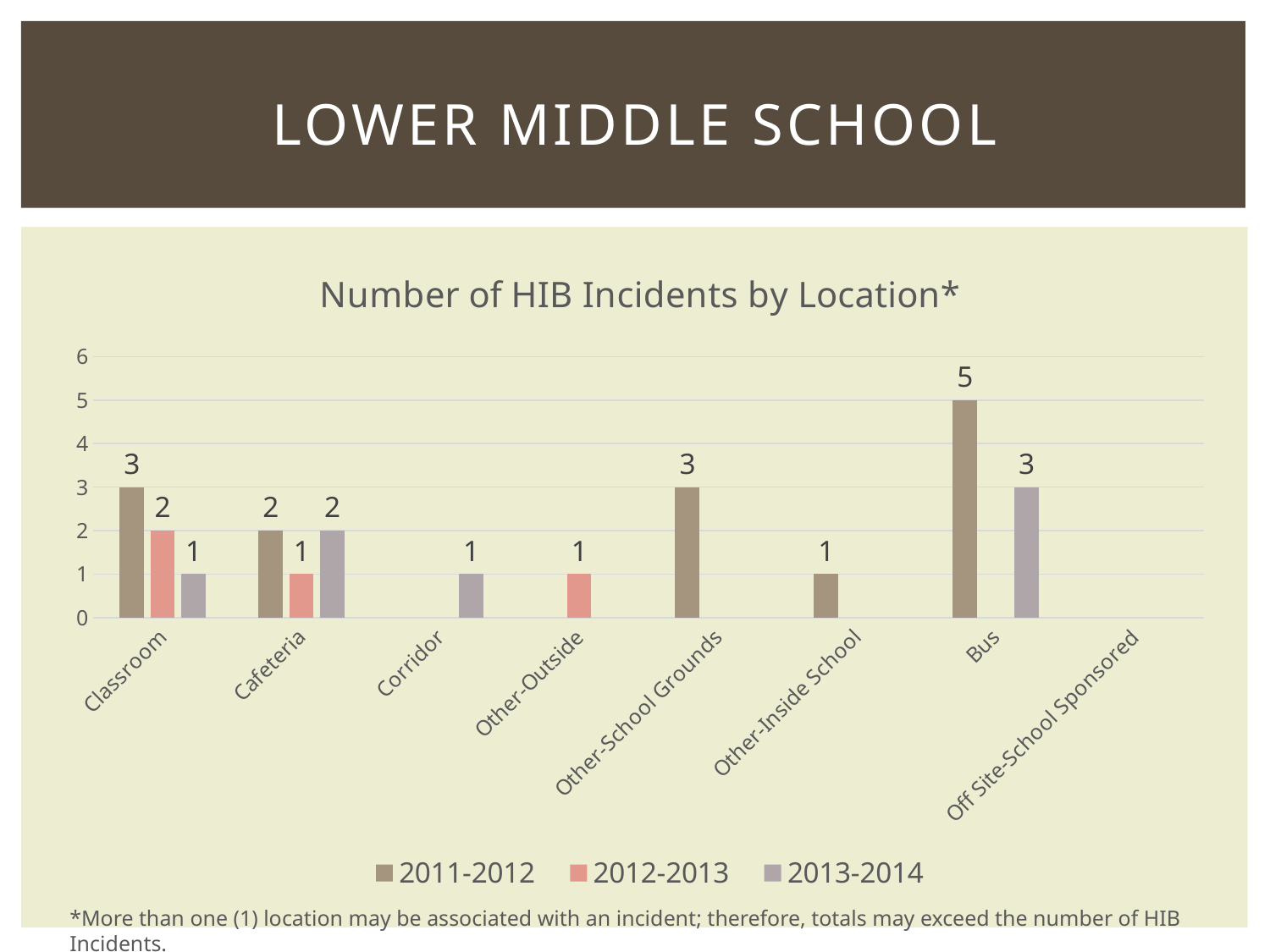
Which is larger: the Classroom value for 2011-2012 or the Cafeteria value for 2011-2012? Classroom Which location has the highest single value in the chart? Bus What is the number of HIB incidents on the Bus for 2013-2014? 3 What is the value for Other-School Grounds in 2011-2012? 3 What is the number of HIB incidents in the Cafeteria for 2012-2013? 1 How many location categories are shown on the x axis? 8 How many series does the legend list? 3 What type of chart is shown on the slide? bar chart What is the number of HIB incidents in the Classroom for 2011-2012? 3 What is the title of the chart? Number of HIB Incidents by Location* What is the difference between the Bus values for 2011-2012 and 2013-2014? 2 Which series is shown in the legend with a pink/red colour? 2012-2013